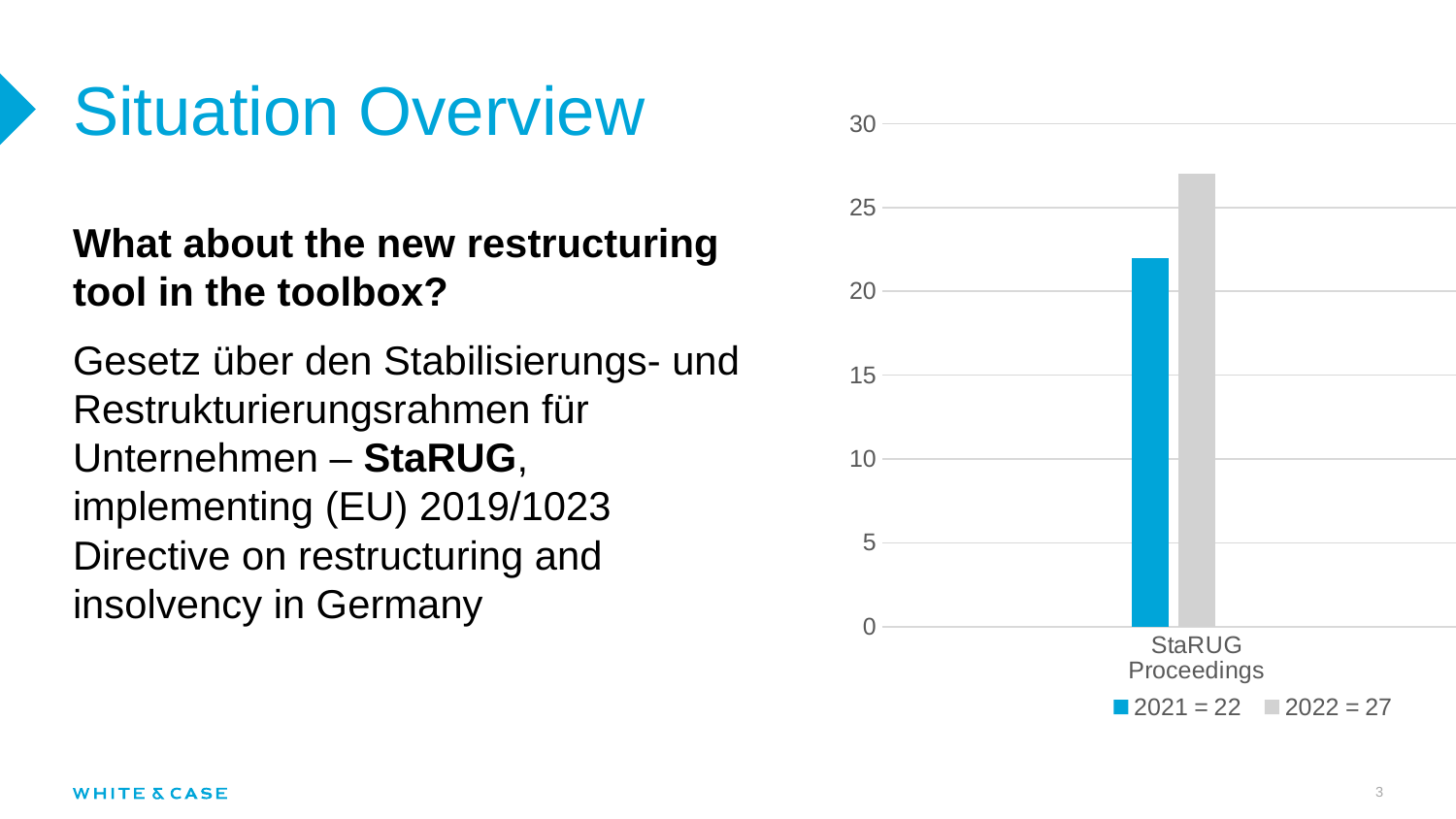
What kind of chart is shown on the slide? bar chart How many series does the chart legend list? 2 How many categories are shown on the x axis of the chart? 1 Is the value for 2022 StaRUG Proceedings greater or less than 25? greater Is the value for 2021 StaRUG Proceedings greater or less than 25? less What is the value of StaRUG Proceedings for 2022? 27 What is the category label shown on the x axis of the chart? StaRUG Proceedings What colour is the bar for the 2021 series? blue Which year has the higher value for StaRUG Proceedings, 2021 or 2022? 2022 What is the value of StaRUG Proceedings for 2021? 22 What is the difference between the 2022 and 2021 values for StaRUG Proceedings? 5 Which series has the lowest value in the chart? 2021